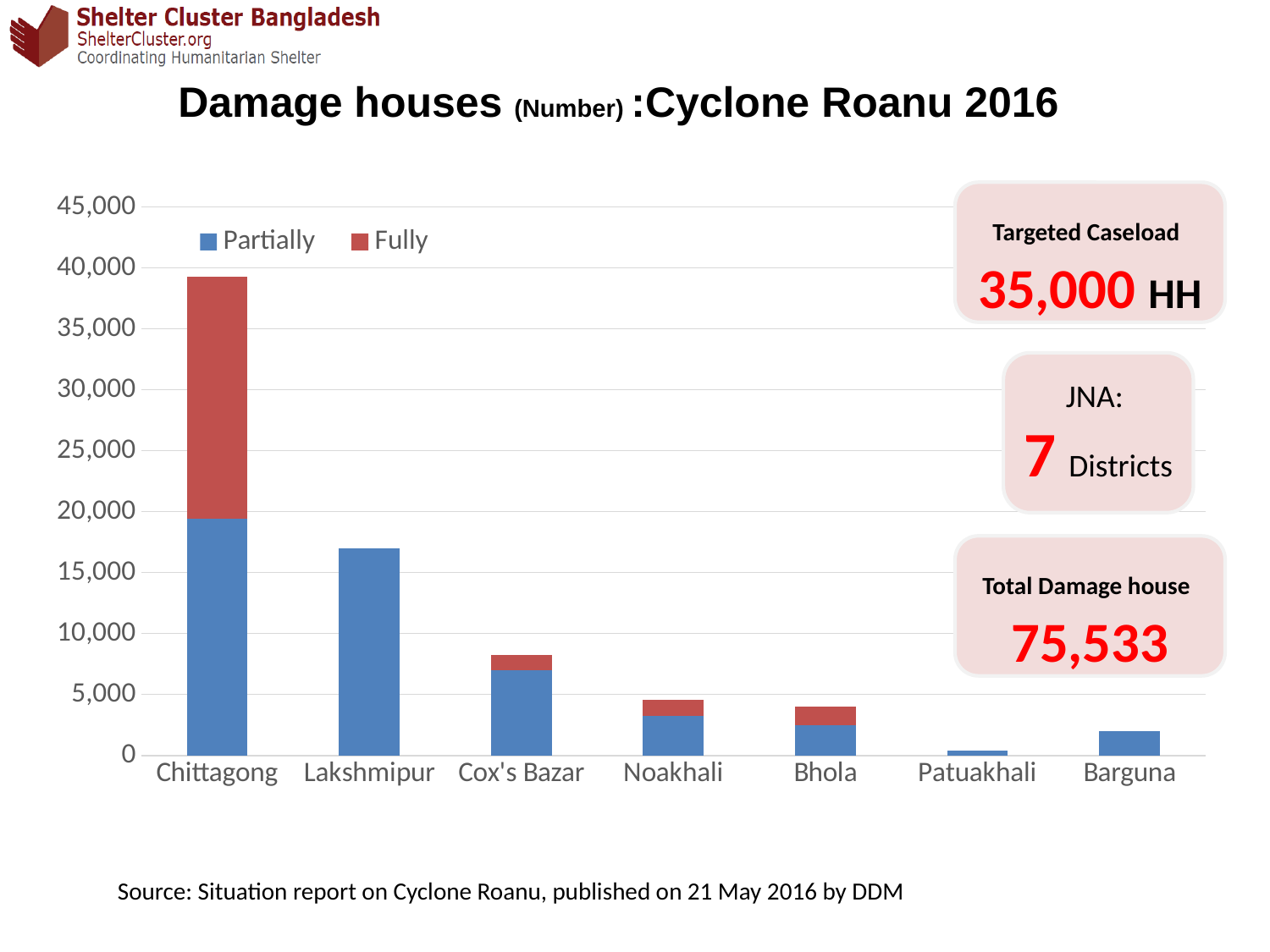
How many series does the chart legend list? 2 Which has a taller bar, Lakshmipur or Cox's Bazar? Lakshmipur Which district has the tallest bar in the chart? Chittagong Is the value for Lakshmipur greater or less than 15,000? greater Is the total bar height for Chittagong greater or less than 35,000? greater What are the two series named in the chart legend? Partially and Fully Which series is shown in red in the chart? Fully Is the value for Barguna greater or less than 5,000? less Which district has the shortest bar in the chart? Patuakhali What kind of chart is shown on the slide? bar chart How many districts are shown on the x axis of the chart? 7